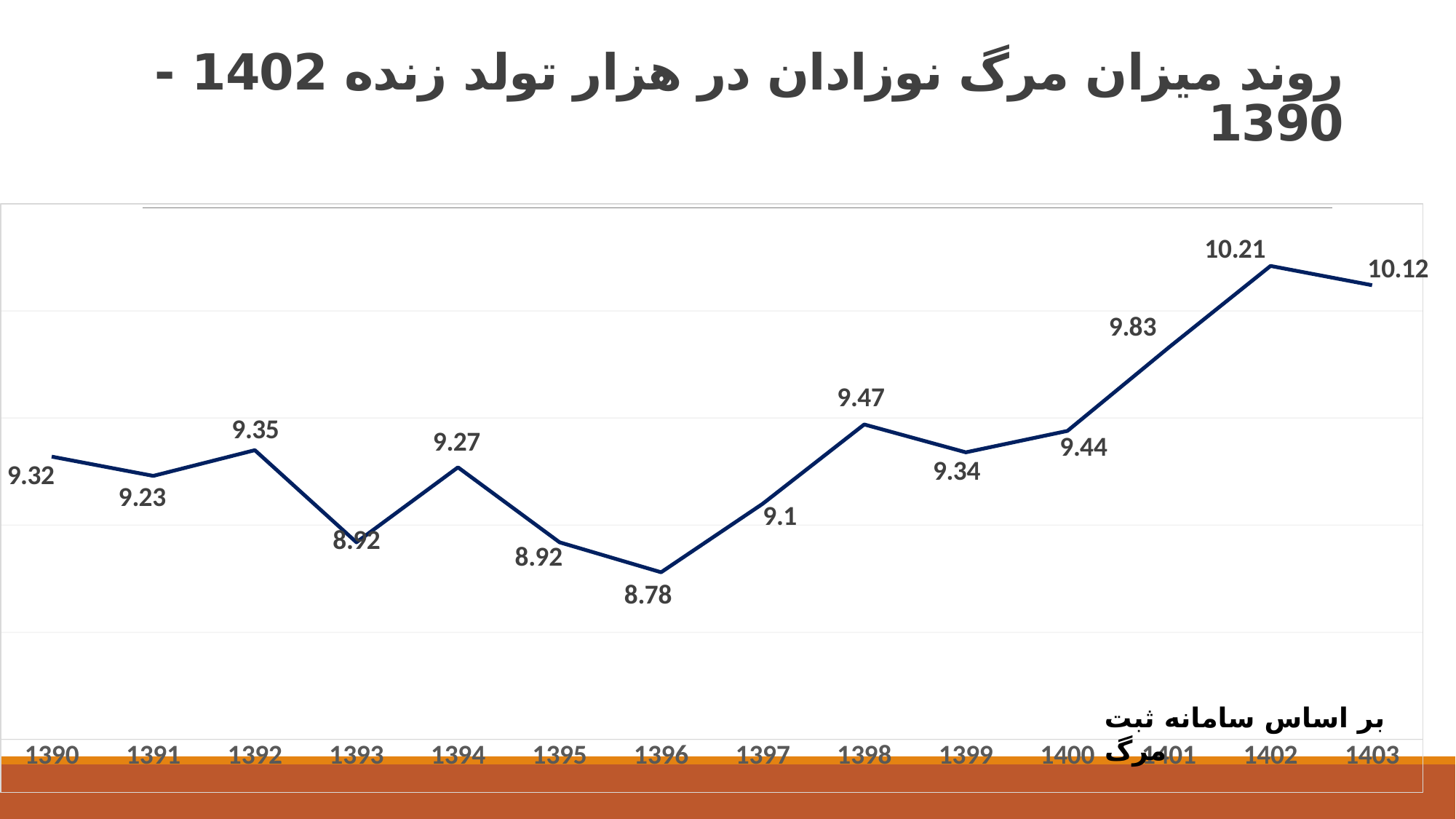
Do the values generally rise or fall from 1396 to 1402? Rise Which year has the highest value? 1402 What is the value for 1402? 10.21 What is the difference between the values for 1403 and 1401? 0.29 What is the value for 1396? 8.78 What is the value for 1390? 9.32 How many years are plotted on the x axis? 14 What is the value for 1398? 9.47 What kind of chart is shown on the slide? Line chart Which year has the lowest value? 1396 Which is larger, the value for 1394 or the value for 1399? 1399 What is the difference between the values for 1402 and 1396? 1.43